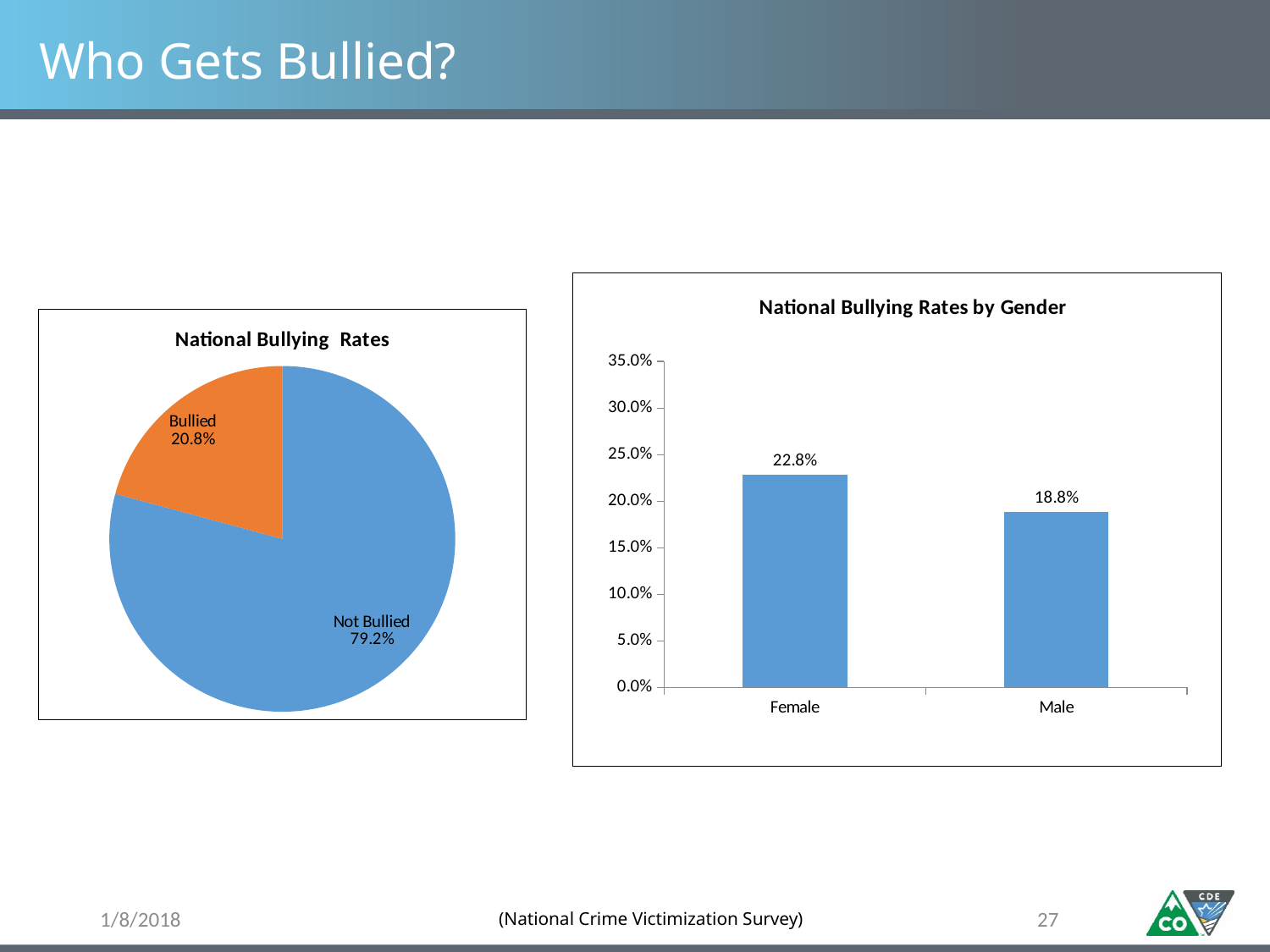
In the 'National Bullying Rates' pie chart, which slice is larger, Bullied or Not Bullied? Not Bullied In the 'National Bullying Rates' pie chart, what share is labelled Not Bullied? 79.2% In the 'National Bullying Rates by Gender' chart, which category has the higher value? Female In the 'National Bullying Rates' pie chart, what colour is the Bullied slice? Orange In the 'National Bullying Rates by Gender' chart, what is the value for Female? 22.8% In the 'National Bullying Rates by Gender' chart, what is the difference between the Female and Male values? 4.0% What kind of chart is the 'National Bullying Rates by Gender' chart on the right? Bar chart How many slices does the 'National Bullying Rates' pie chart have? 2 In the 'National Bullying Rates' pie chart, what share is labelled Bullied? 20.8% In the 'National Bullying Rates by Gender' chart, is the value for Male greater or less than 20.0%? less What kind of chart is the 'National Bullying Rates' chart on the left? Pie chart In the 'National Bullying Rates by Gender' chart, what is the value for Male? 18.8%